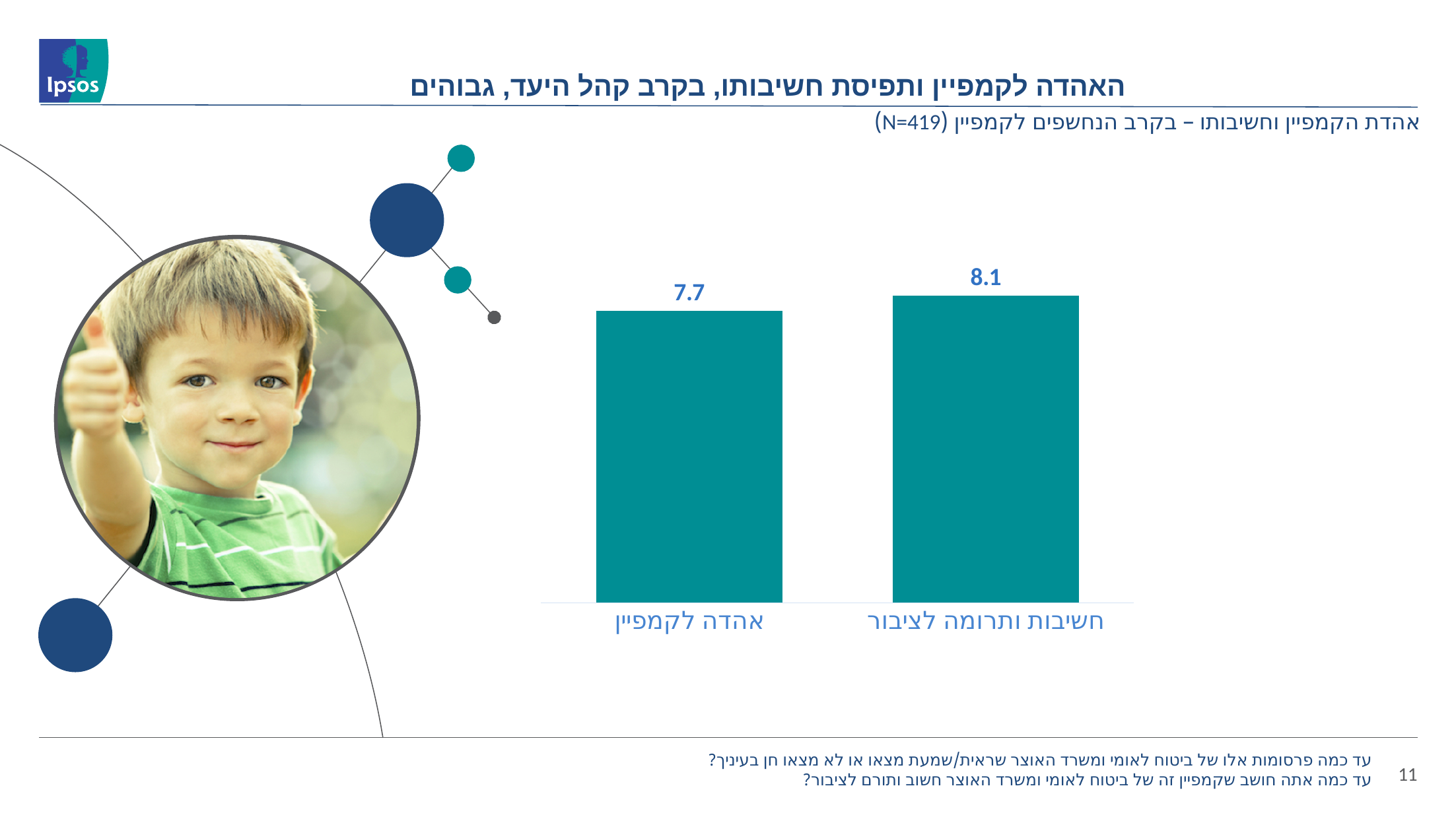
Which category has the highest value? חשיבות ותרומה לציבור How many categories are shown in the chart? 2 What colour are the bars in the chart? teal Which is larger: the value for אהדה לקמפיין or the value for חשיבות ותרומה לציבור? חשיבות ותרומה לציבור What kind of chart is shown on the slide? bar chart What is the difference between the values for חשיבות ותרומה לציבור and אהדה לקמפיין? 0.4 Which category has the lowest value? אהדה לקמפיין What sample size (N) is stated in the chart subtitle? N=419 What is the value for אהדה לקמפיין? 7.7 What is the value for חשיבות ותרומה לציבור? 8.1